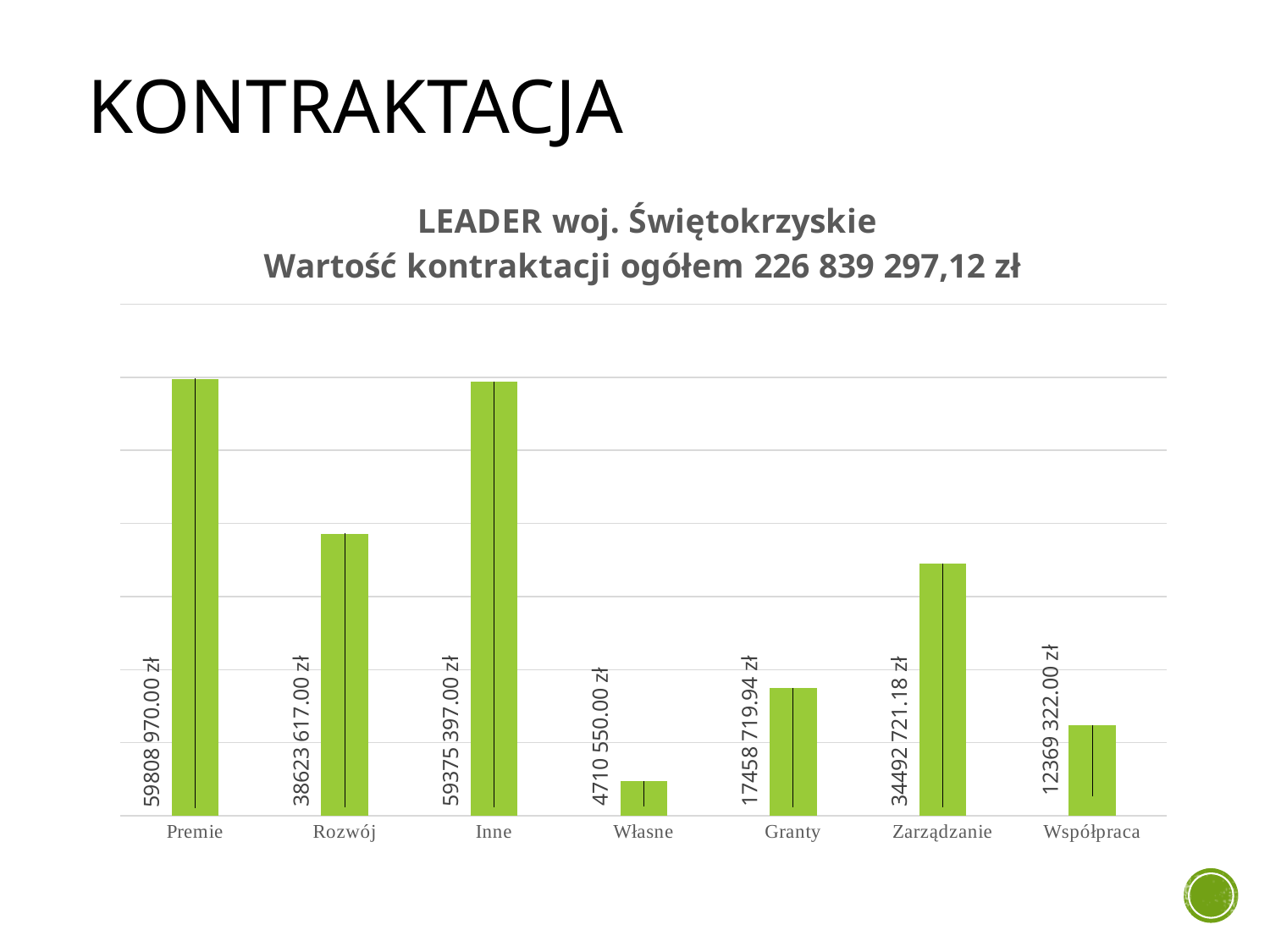
What is the value for Zarządzanie? 34492 721.18 zł Which is larger, Rozwój or Zarządzanie? Rozwój What is the value for Własne? 4710 550.00 zł Which category has the highest value? Premie What total contract value (Wartość kontraktacji ogółem) is stated in the chart title? 226 839 297,12 zł Which category has the lowest value? Własne What is the difference between Premie and Inne? 433 573.00 zł How many categories are shown on the x axis? 7 What is the value for Premie? 59808 970.00 zł What kind of chart is this? Bar chart What is the value for Granty? 17458 719.94 zł What is the difference between Granty and Współpraca? 5089 397.94 zł